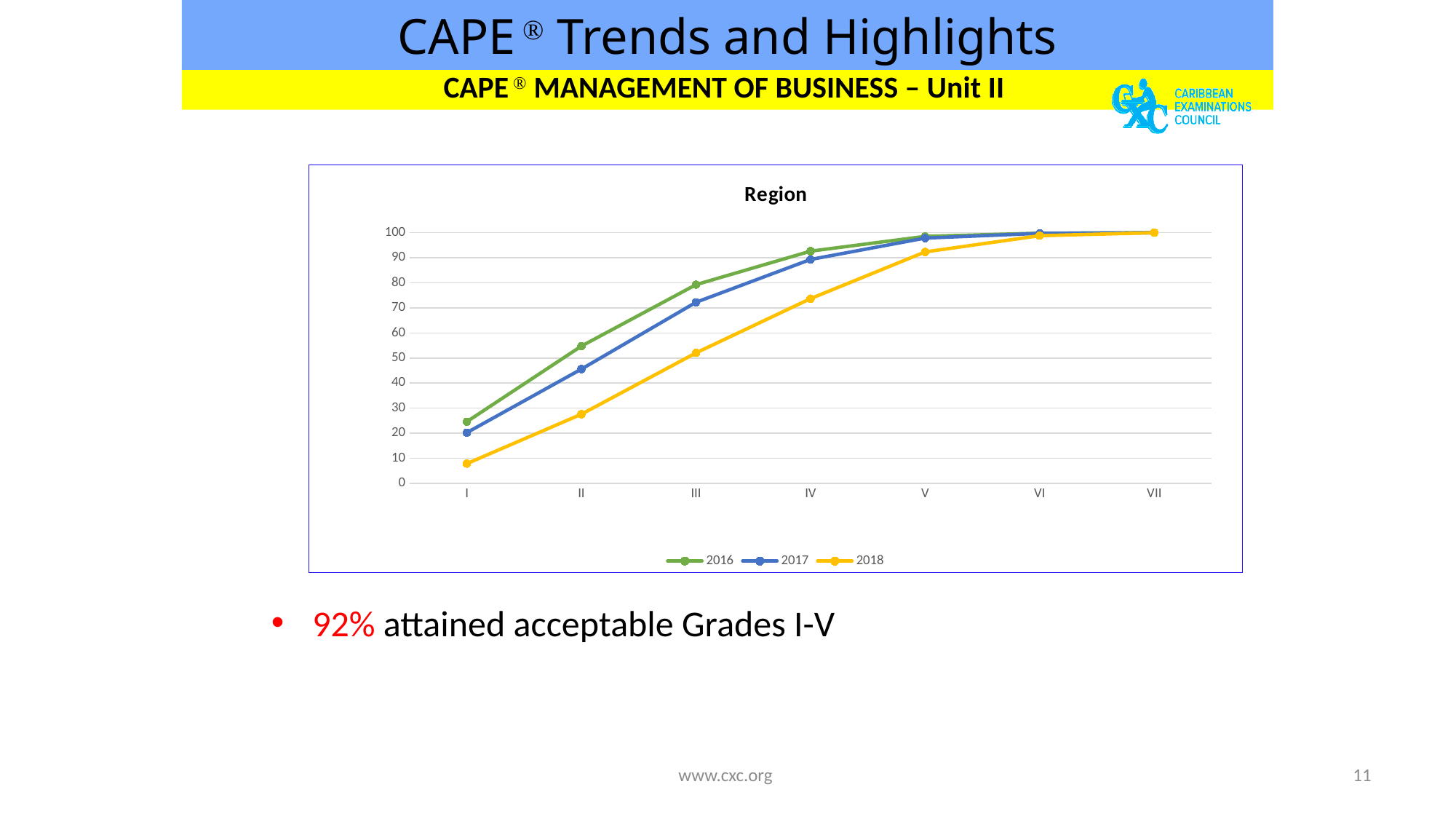
At Grade III, which series has the larger value, 2016 or 2018? 2016 Is the value for 2018 at Grade I greater or less than 20? less Is the value for 2016 at Grade II greater or less than 50? greater How many grade categories are shown on the x axis? 7 Is the value for 2017 at Grade IV greater or less than 80? greater What is the title of the chart? Region Which series has the lowest value at Grade I? 2018 Which series has the highest value at Grade II? 2016 How many series does the legend list? 3 What kind of chart is shown on the slide? line chart Do the values for the 2018 series rise or fall from Grade I to Grade VII? rise